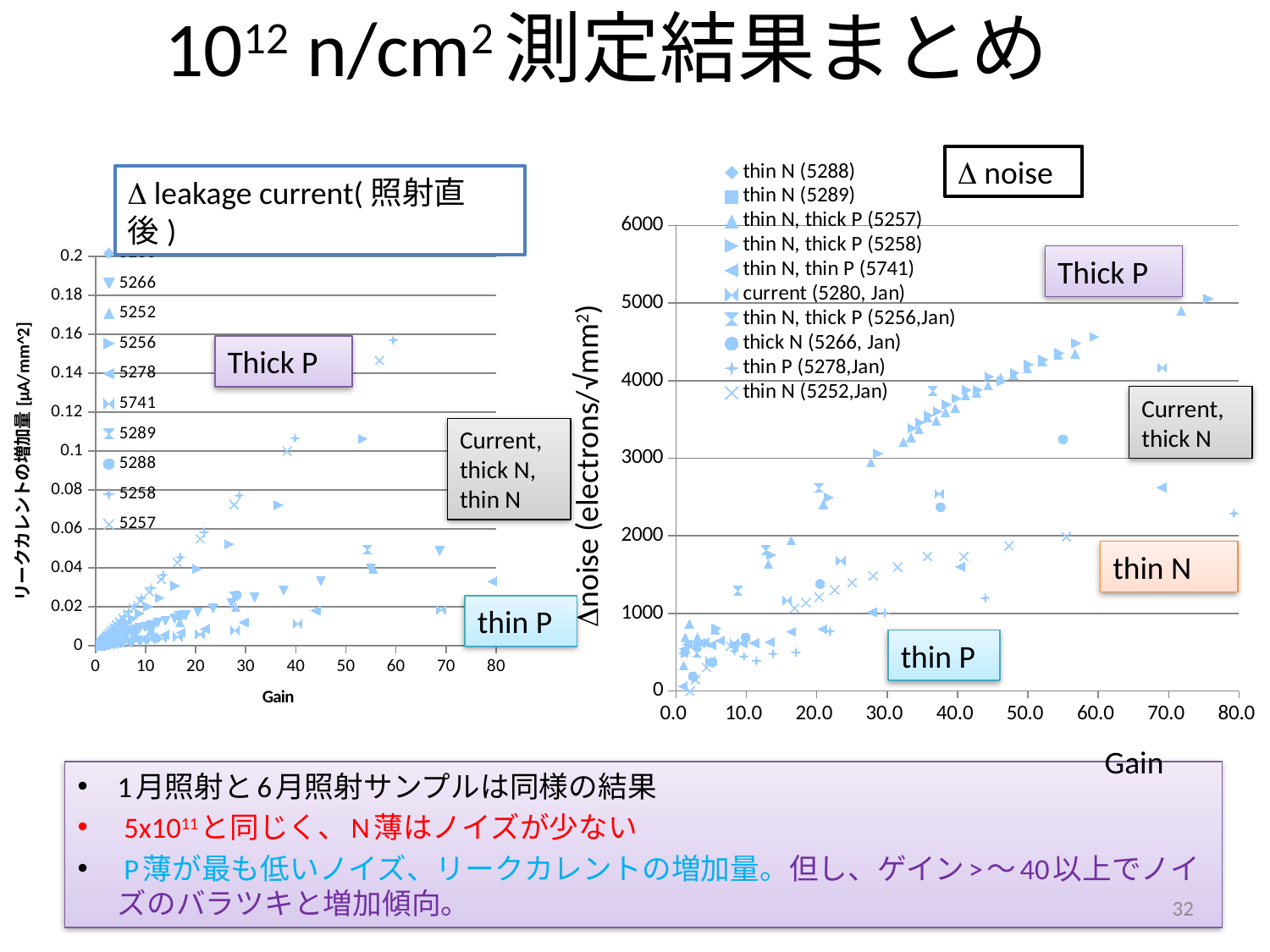
In the Δ noise chart, is the highest plotted Δ noise value greater or less than 4000? greater How many series does the legend of the Δ noise chart list? 10 What is the maximum value shown on the y-axis of the Δ noise chart? 6000 What kind of chart is the Δ leakage current chart on the left of the slide? scatter chart What kind of chart is the Δ noise chart on the right of the slide? scatter chart What is the x-axis title of the Δ noise chart? Gain In the Δ leakage current chart, is the highest plotted value greater or less than 0.14? greater In the Δ noise chart, do the Thick P series values rise or fall as Gain increases? rise In the Δ leakage current chart, do the plotted values generally rise or fall as Gain increases? rise What is the y-axis title of the Δ noise chart? Δnoise (electrons/√mm²)